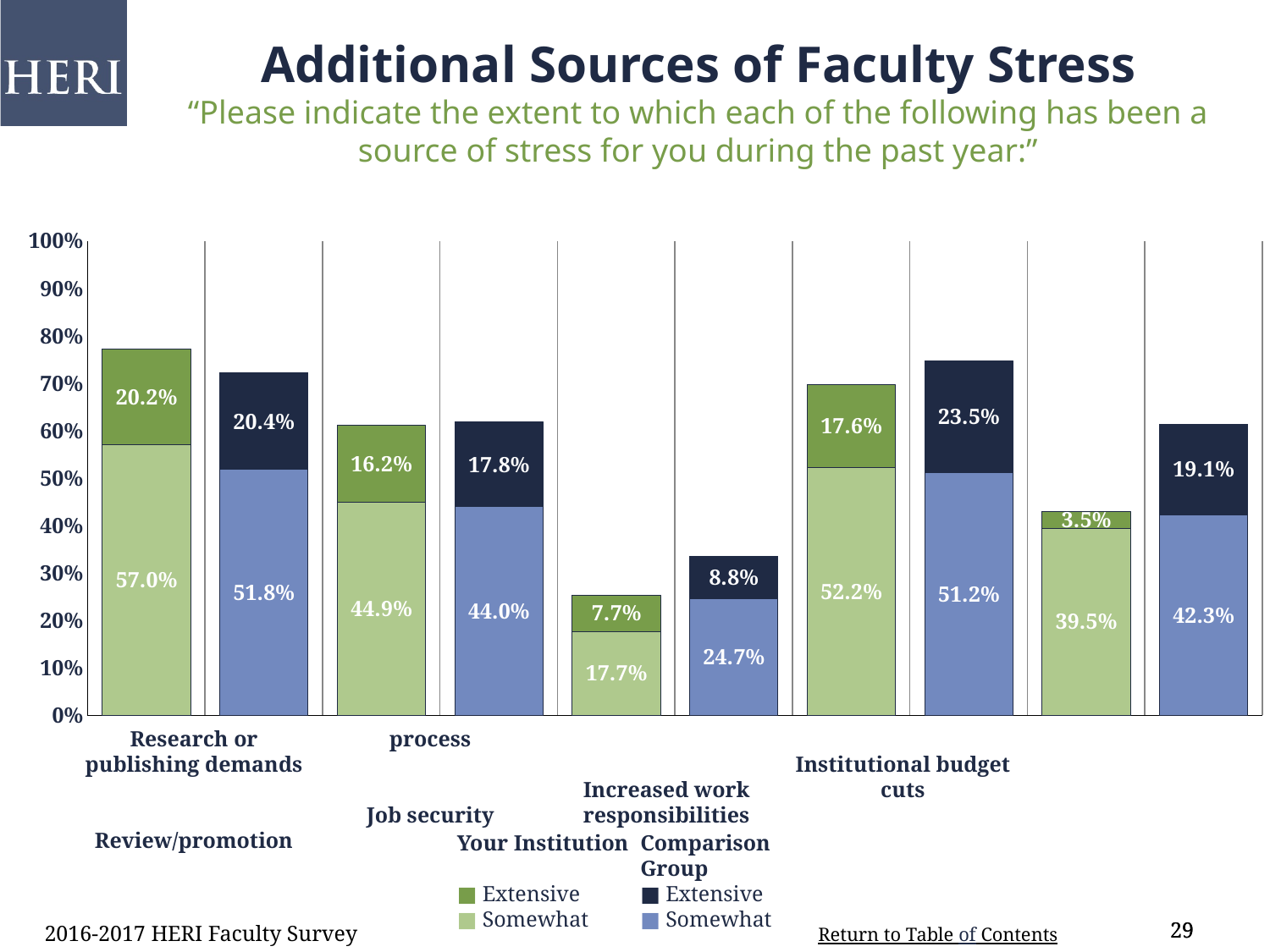
How many bars are plotted in the chart? 10 What kind of chart is shown on the slide? stacked bar chart Which pair of bars has the lowest values overall? the third pair from the left What is the total height of the leftmost Your Institution bar (Somewhat plus Extensive)? 77.2% What is the 'Extensive' value for the second bar from the left (Comparison Group, first pair)? 20.4% What is the 'Somewhat' value for the Comparison Group bar in the rightmost pair? 42.3% Is the 'Somewhat' value for the Your Institution bar in the third pair from the left greater or less than 20%? less Which colour represents 'Extensive' for Your Institution in the legend? dark green What is the total height of the Comparison Group bar in the third pair from the left (24.7% Somewhat plus 8.8% Extensive)? 33.5% What is the difference between the 'Extensive' values of the two bars in the rightmost pair (19.1% vs 3.5%)? 15.6% How many series does the legend list? 4 What is the 'Somewhat' value for the leftmost (Your Institution) bar in the chart? 57.0%